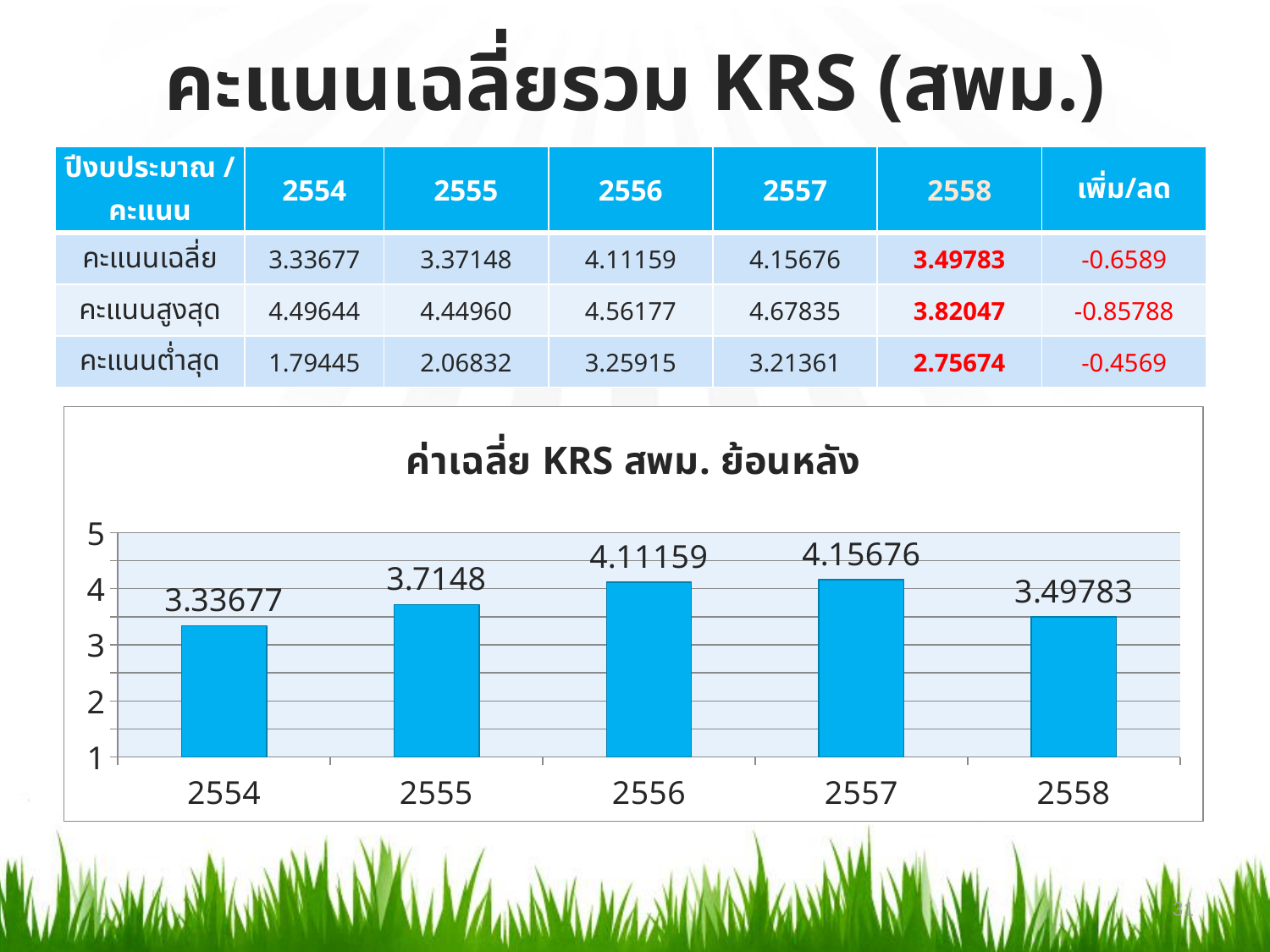
What is the title of the chart? ค่าเฉลี่ย KRS สพม. ย้อนหลัง What is the difference between the values for 2556 and 2558? 0.61376 Which year has the lowest value in the chart? 2554 What is the value for 2554 in the chart? 3.33677 Which is larger, the value for 2556 or the value for 2558? 2556 How many years are shown on the x axis of the chart? 5 Is the value for 2554 greater or less than 4? less Which year has the highest value in the chart? 2557 What is the value for 2558 in the chart? 3.49783 What is the value for 2555 in the chart? 3.7148 What is the difference between the values for 2557 and 2554? 0.81999 What kind of chart is shown on the slide? bar chart